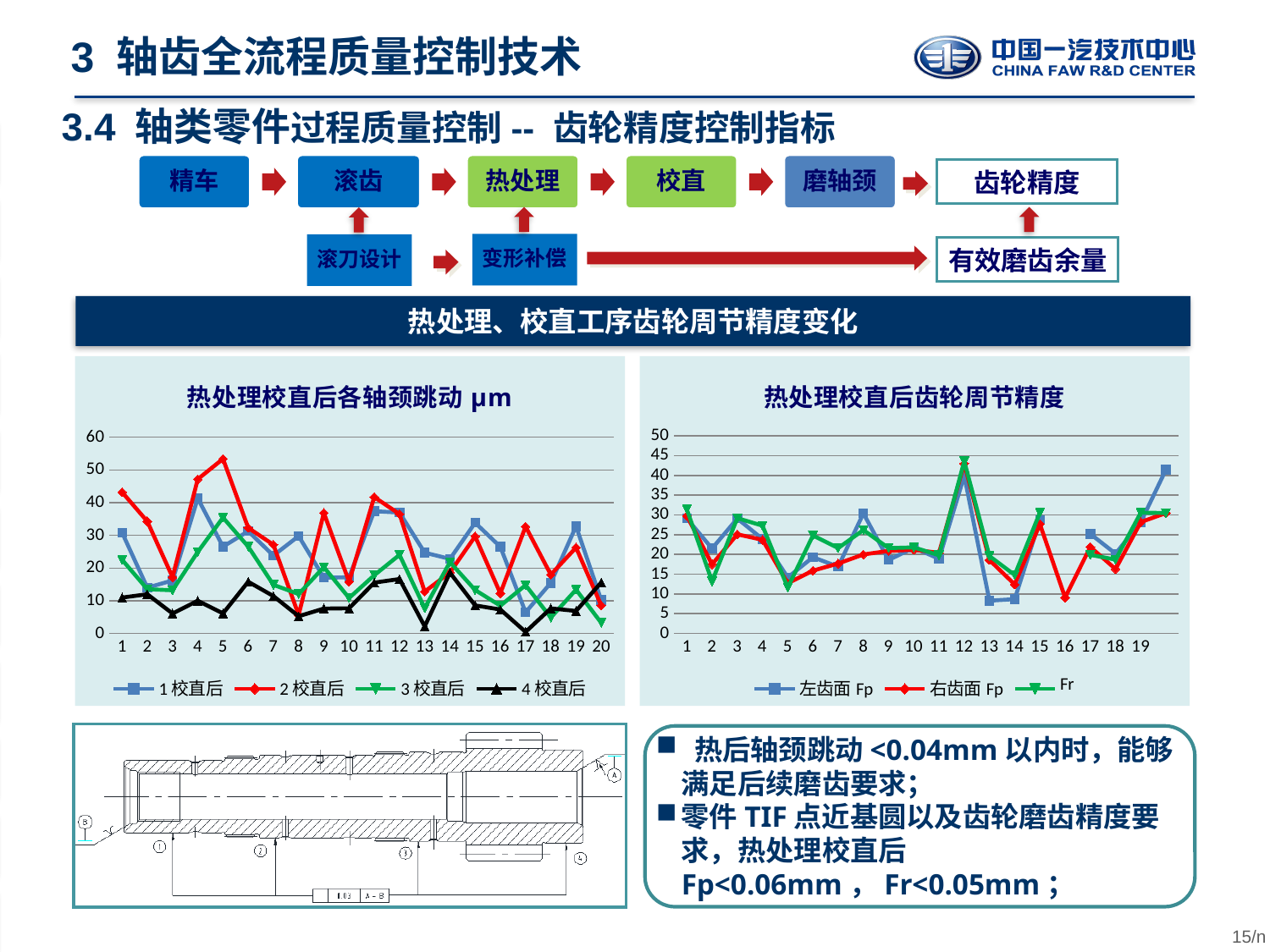
How many series does the legend of the left chart (热处理校直后各轴颈跳动 μm) list? 4 In the right chart (热处理校直后齿轮周节精度), at which point does the Fr series reach its highest value? 12 In the left chart (热处理校直后各轴颈跳动 μm), is the value of 4 校直后 at point 17 greater or less than 10? less What kind of chart is the right chart titled 热处理校直后齿轮周节精度? line chart What kind of chart is the left chart titled 热处理校直后各轴颈跳动 μm? line chart How many series does the legend of the right chart (热处理校直后齿轮周节精度) list? 3 In the left chart (热处理校直后各轴颈跳动 μm), is the value of 2 校直后 at point 5 greater or less than 50? greater How many points are plotted along the x axis of the left chart (热处理校直后各轴颈跳动 μm)? 20 In the left chart (热处理校直后各轴颈跳动 μm), which series reaches the highest value on the chart? 2 校直后 In the right chart (热处理校直后齿轮周节精度), is the value of 左齿面 Fp at point 13 greater or less than 10? less What is the title of the right chart on the slide? 热处理校直后齿轮周节精度